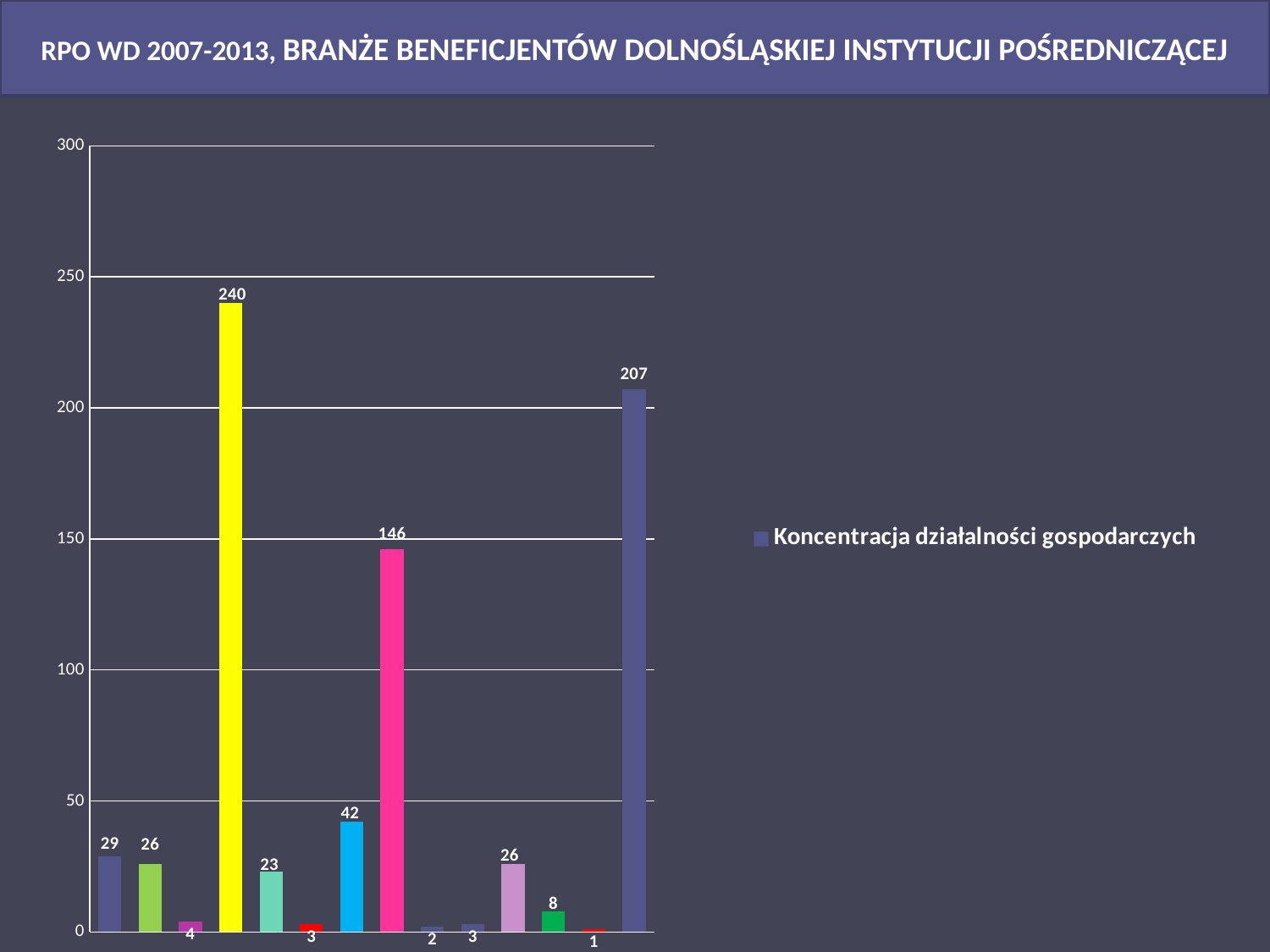
Which is larger: the yellow bar or the pink bar? the yellow bar What is the value of the pink bar? 146 What is the legend entry shown on the slide? Koncentracja działalności gospodarczych What is the difference between the yellow bar (240) and the rightmost bar (207)? 33 What is the highest value shown in the chart? 240 What is the lowest value shown in the chart? 1 What is the value of the leftmost bar? 29 How many bars are plotted in the chart? 14 What is the value of the yellow bar? 240 What is the value of the rightmost bar? 207 How many series does the legend list? 1 What kind of chart is shown on the slide? bar chart